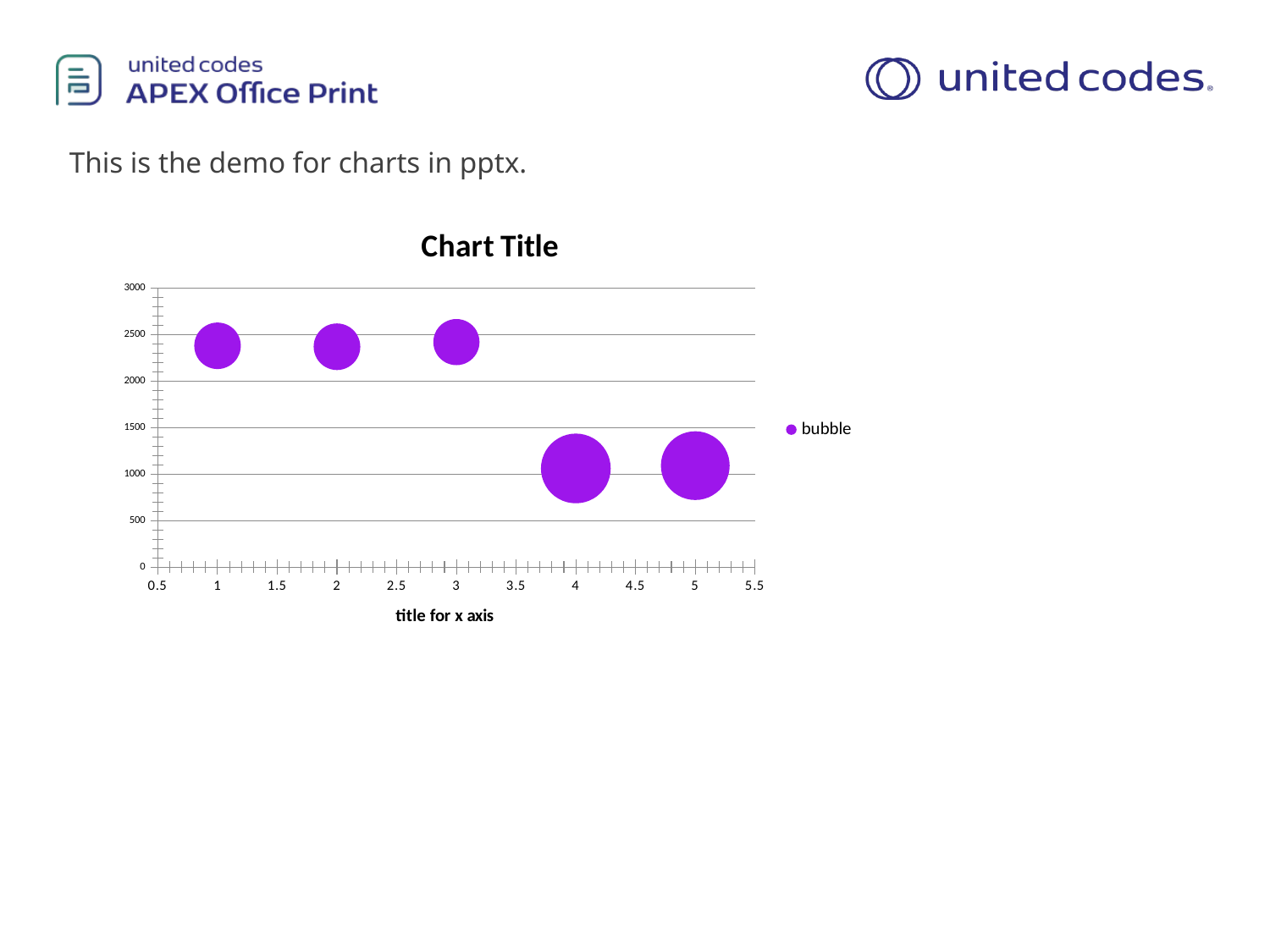
Is the y value of the bubble at x = 5 greater or less than 500? greater What kind of chart is shown on the slide? bubble chart Is the y value of the bubble at x = 4 greater or less than 1500? less Which bubble has the larger y value, the one at x = 1 or the one at x = 4? x = 1 What is the name of the series shown in the legend? bubble What is the title of the chart's x axis? title for x axis Is the y value of the bubble at x = 1 greater or less than 2000? greater Which bubble has the larger y value, the one at x = 3 or the one at x = 5? x = 3 How many bubbles are plotted in the chart? 5 How many series does the chart legend list? 1 Do the y values of the bubbles generally rise or fall as x increases from 1 to 5? fall